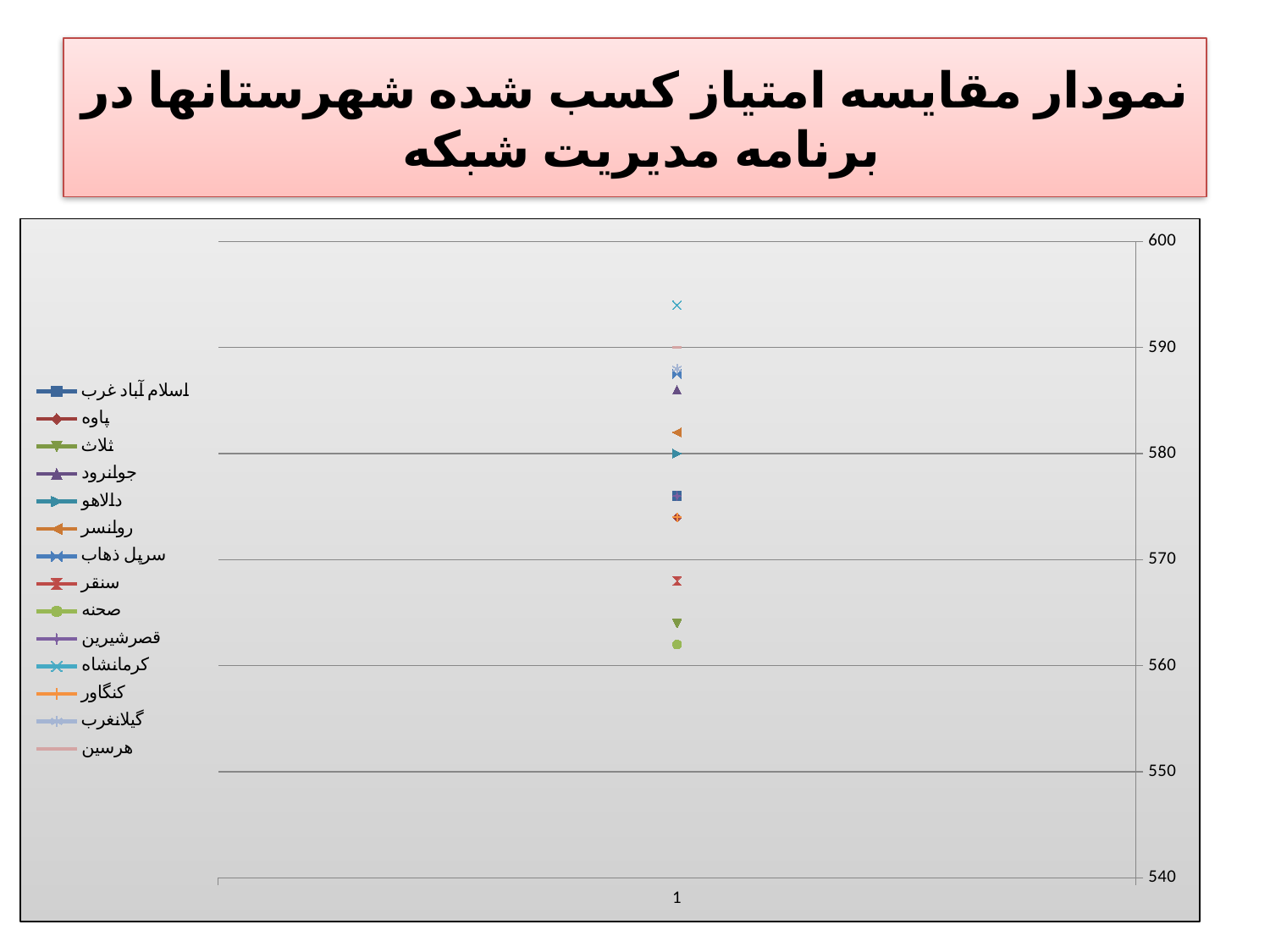
Is the value for جوانرود greater or less than 580? greater Which series has the highest plotted value? کرمانشاه What kind of chart is shown on the slide? line chart Is the value for صحنه greater or less than 570? less Which has the larger value, سنقر or ثلاث? سنقر Which series has the lowest plotted value? صحنه Which has the larger value, کرمانشاه or صحنه? کرمانشاه How many categories are shown on the x axis? 1 Is the value for اسلام آباد غرب greater or less than 580? less How many series does the legend list? 14 What is the highest value shown on the y axis? 600